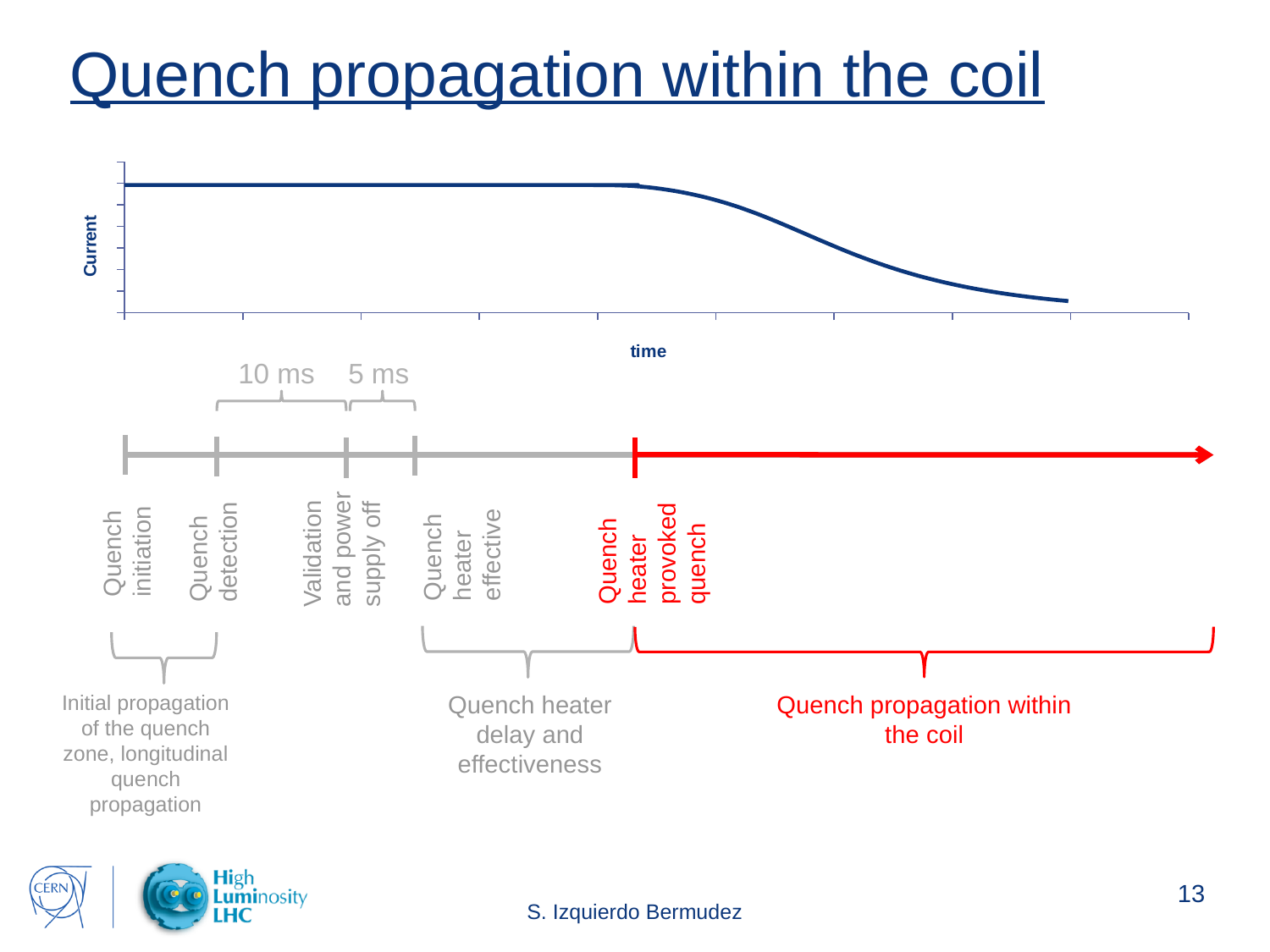
What is the label of the vertical axis of the chart? Current According to the timeline below the chart, how long is the interval between validation and power supply off and quench heater effective? 5 ms How many lines (series) are plotted on the chart? 1 Does the current rise, fall, or stay flat along the time axis in the left-hand part of the chart? stay flat Which of the two labelled intervals on the timeline is longer, the one labelled 10 ms or the one labelled 5 ms? 10 ms What kind of chart is shown at the top of the slide? line chart What is the label of the horizontal axis of the chart? time Which event on the timeline is highlighted in red? Quench heater provoked quench How many labelled events are marked on the timeline below the chart? 5 Does the current rise, fall, or stay flat along the time axis in the right-hand part of the chart? fall According to the timeline below the chart, how long is the interval between quench detection and validation and power supply off? 10 ms What is the difference between the two labelled intervals on the timeline, 10 ms and 5 ms? 5 ms